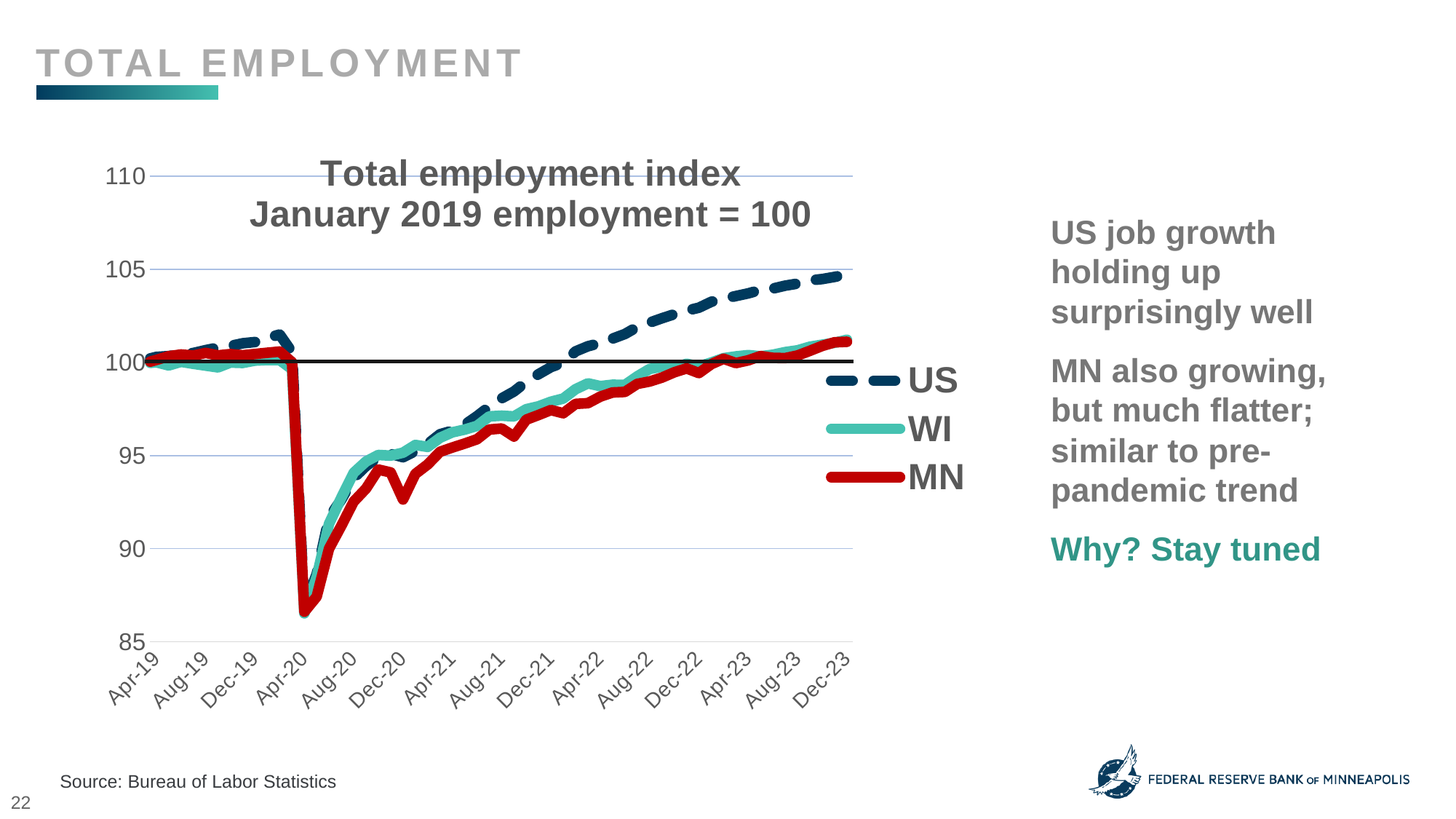
At Dec-23, is the value for US greater or less than 100? greater What is the title of the chart? Total employment index January 2019 employment = 100 Do the values for US rise or fall from Apr-20 to Dec-23? rise What are the series listed in the legend? US, WI, MN At Apr-20, is the value for MN greater or less than 90? less At Apr-22, is the value for US greater or less than 100? greater At Dec-23, which is larger, the value for US or the value for MN? US Which series has the highest value at Dec-23? US How many date labels are shown on the x axis? 15 How many series does the legend list? 3 What kind of chart is shown on the slide? line chart